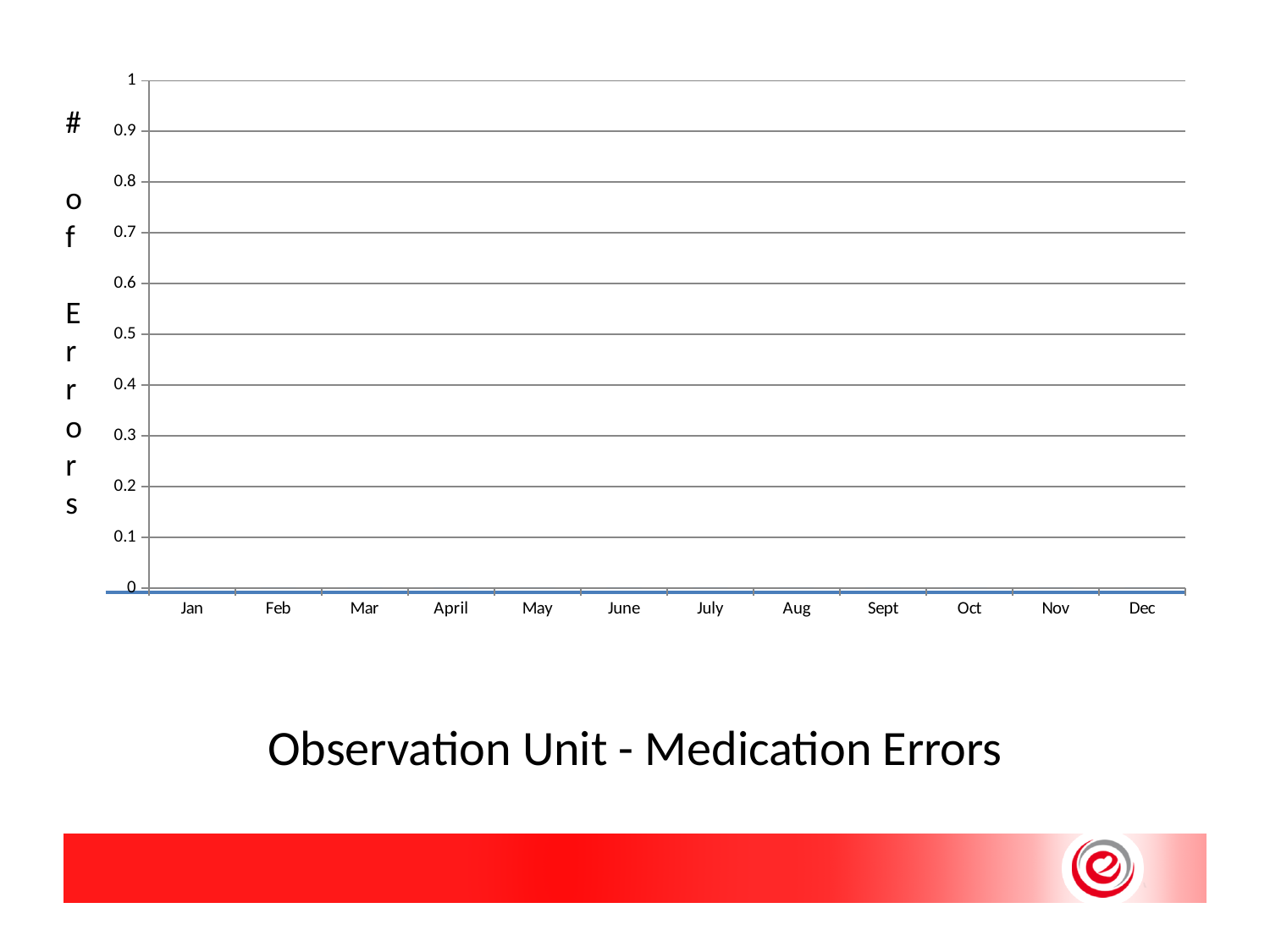
What is the number of errors plotted for Dec? 0 Is the value for Oct greater or less than 0.1? less What is the title of the chart? Observation Unit - Medication Errors What is the highest value shown on the vertical axis? 1 What is the number of errors plotted for Jan? 0 How many months are shown along the x axis of the chart? 12 What kind of chart is shown on the slide? bar chart What is the difference between the values for Jan and Dec? 0 What is the label on the vertical axis of the chart? # of Errors Is the value for Mar greater or less than 0.5? less What is the number of errors plotted for July? 0 Do the plotted values rise, fall, or stay flat from Jan to Dec? stay flat